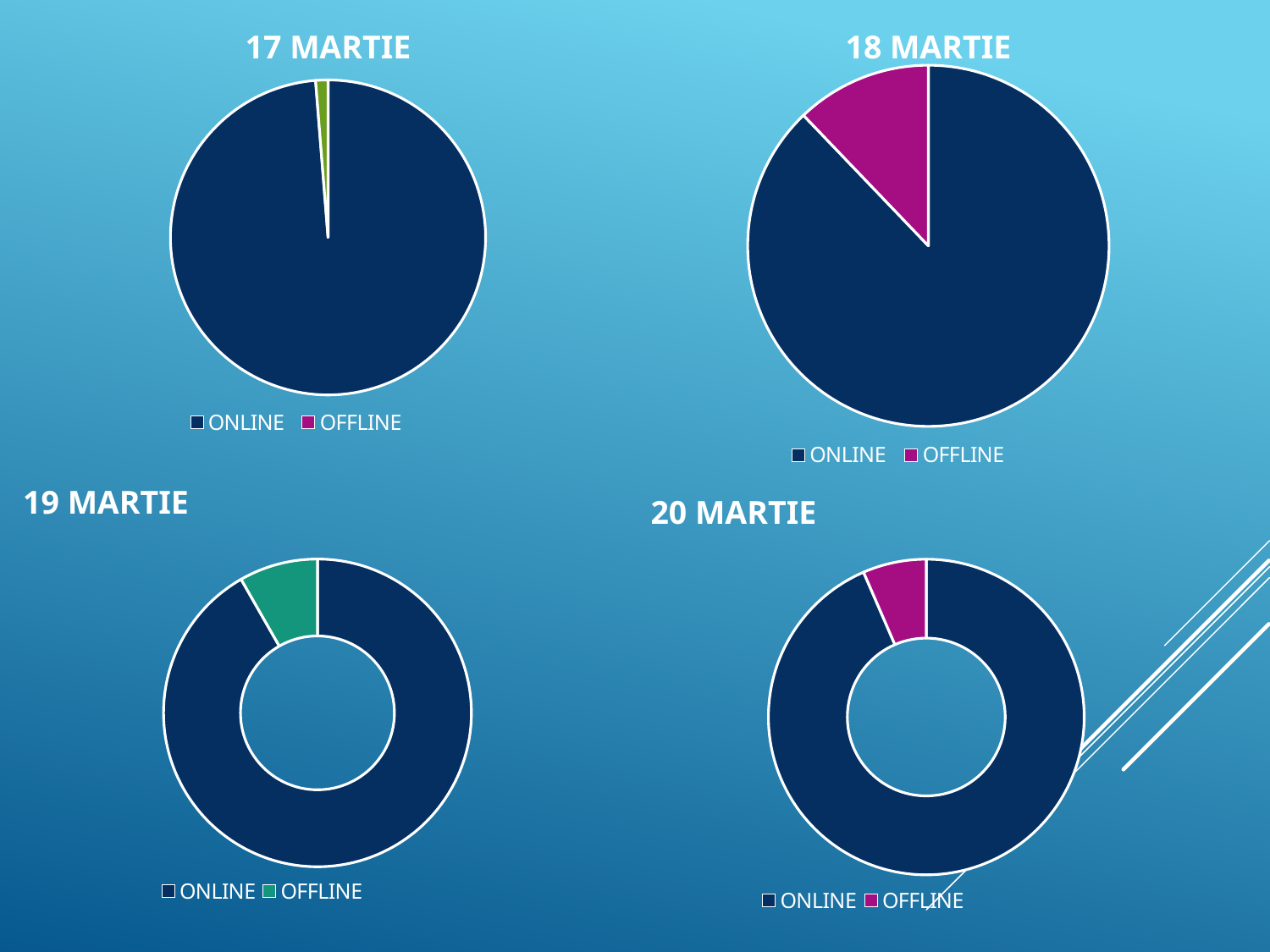
What kind of chart is the 19 MARTIE chart? doughnut chart In the 18 MARTIE chart, which is larger, OFFLINE or ONLINE? ONLINE In the 17 MARTIE chart, which category has the largest share? ONLINE How many categories does the legend of the 18 MARTIE chart list? 2 In the 19 MARTIE chart, which is larger, ONLINE or OFFLINE? ONLINE What kind of chart is the 20 MARTIE chart? doughnut chart How many charts are shown on the slide? 4 In the 20 MARTIE chart, which category has the smallest share? OFFLINE What is the title of the chart in the bottom-left of the slide? 19 MARTIE In the 18 MARTIE chart, which category has the smallest share? OFFLINE What kind of chart is the 17 MARTIE chart? pie chart What are the two legend entries in the 20 MARTIE chart? ONLINE and OFFLINE